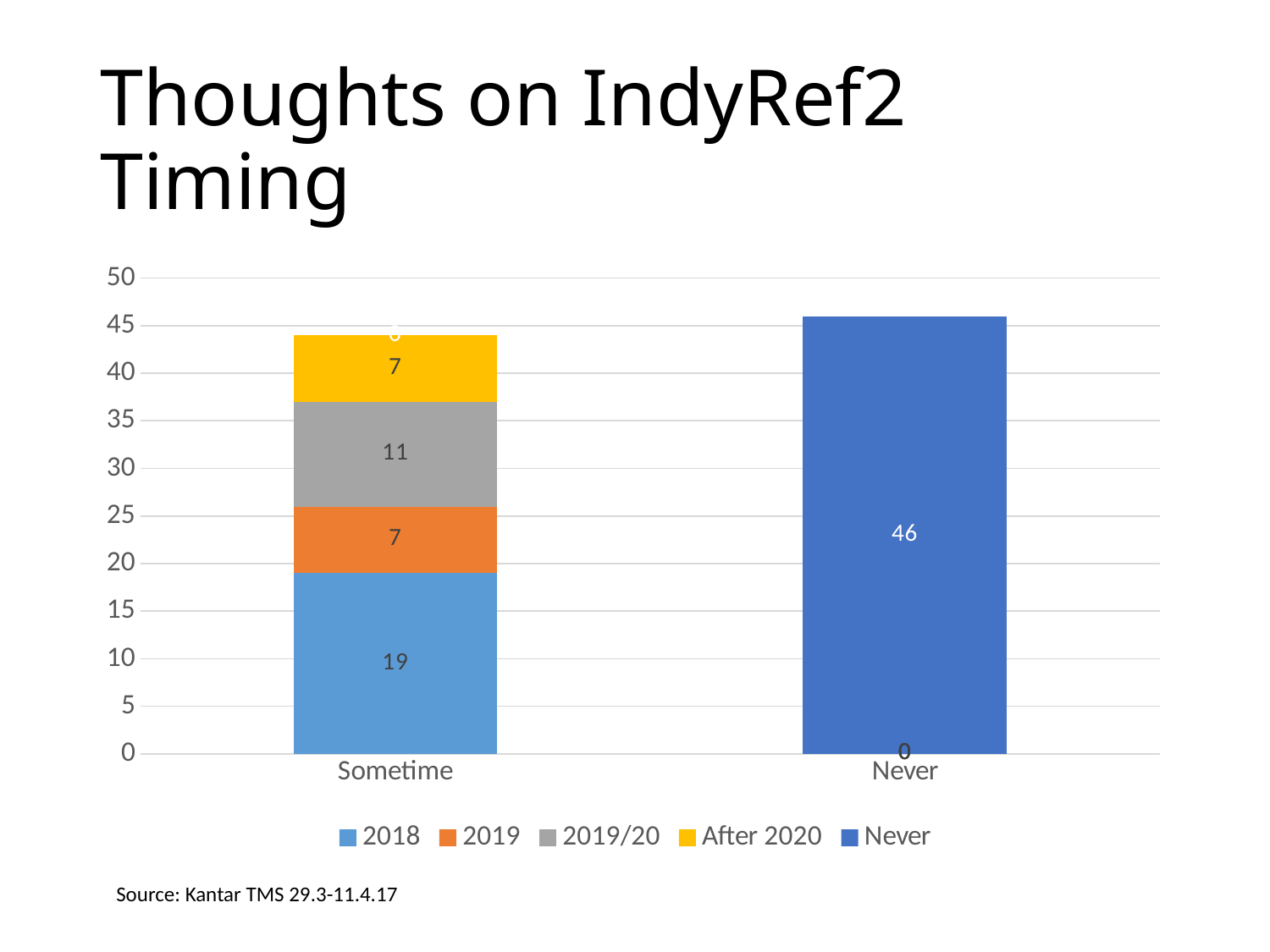
What is the value for After 2020 in the Sometime bar? 7 What is the value for 2018 in the Sometime bar? 19 How many categories are shown on the x axis? 2 What is the value for Never in the Never bar? 46 What is the difference between the 2018 value and the 2019/20 value in the Sometime bar? 8 How many series does the legend list? 5 Which series has the largest segment in the Sometime bar? 2018 Is the value for Never greater or less than 40? greater What kind of chart is shown on the slide? Stacked bar chart What is the value for 2019/20 in the Sometime bar? 11 Which is larger: the 2019/20 segment or the 2019 segment in the Sometime bar? 2019/20 What is the total of the Sometime stacked bar? 44